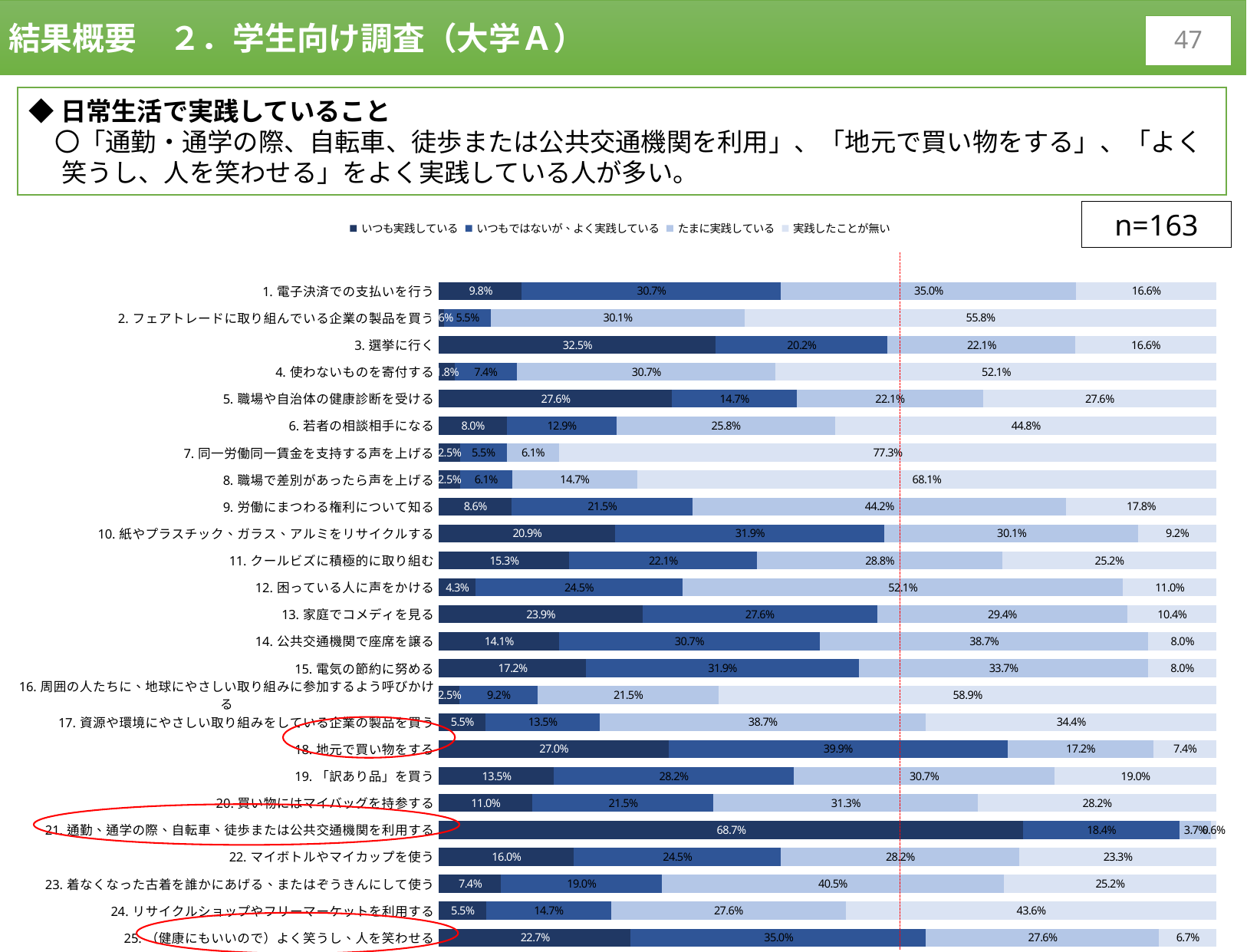
Which has a larger いつも実践している value: item 10 (紙やプラスチック、ガラス、アルミをリサイクルする) or item 13 (家庭でコメディを見る)? 13. 家庭でコメディを見る What is the value of いつも実践している for item 21 (通勤、通学の際、自転車、徒歩または公共交通機関を利用する)? 68.7% What is the value of たまに実践している for item 1 (電子決済での支払いを行う)? 35.0% What is the value of いつもではないが、よく実践している for item 18 (地元で買い物をする)? 39.9% Which item has the highest value for 実践したことが無い? 7. 同一労働同一賃金を支持する声を上げる How many series does the legend list? 4 What is the sample size (n) shown on the slide? n=163 Which item has the highest value for いつも実践している? 21. 通勤、通学の際、自転車、徒歩または公共交通機関を利用する What is the difference between the いつも実践している values for item 21 (68.7%) and item 3 (選挙に行く, 32.5%)? 36.2 percentage points What kind of chart is shown on the slide? stacked bar chart How many categories (items) are plotted in the chart? 25 What is the value of 実践したことが無い for item 7 (同一労働同一賃金を支持する声を上げる)? 77.3%